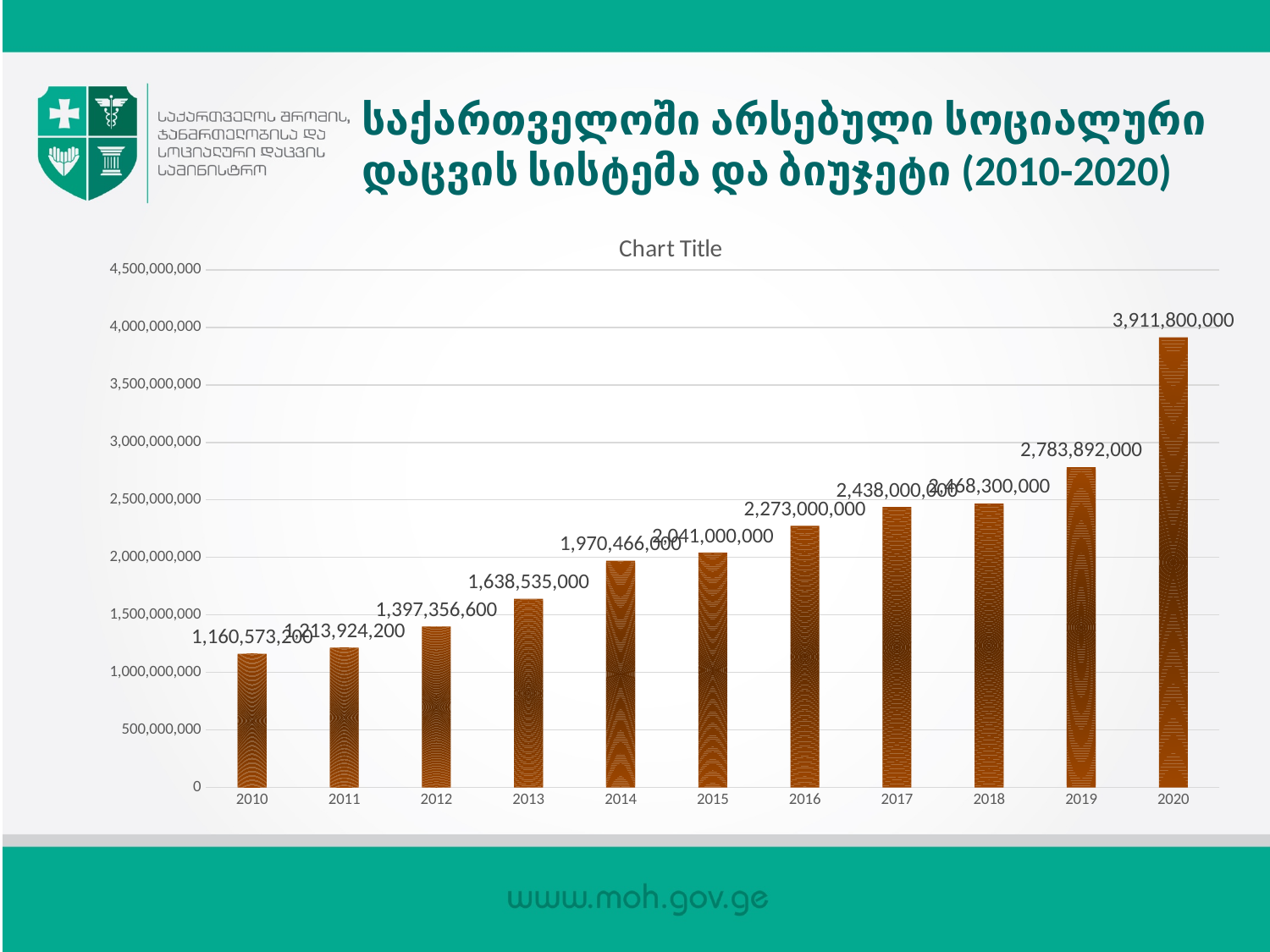
Is the value for 2015 greater or less than 2,000,000,000? greater What is the value for 2016? 2,273,000,000 Which year has the lowest value? 2010 What is the difference between the values for 2013 and 2012? 241,178,400 Do the values rise or fall from 2010 to 2020? rise What kind of chart is shown on the slide? bar chart What is the difference between the values for 2020 and 2019? 1,127,908,000 How many years are shown on the x axis? 11 What is the value for 2012? 1,397,356,600 Which year has the highest value? 2020 What is the value for 2019? 2,783,892,000 What is the value for 2020? 3,911,800,000